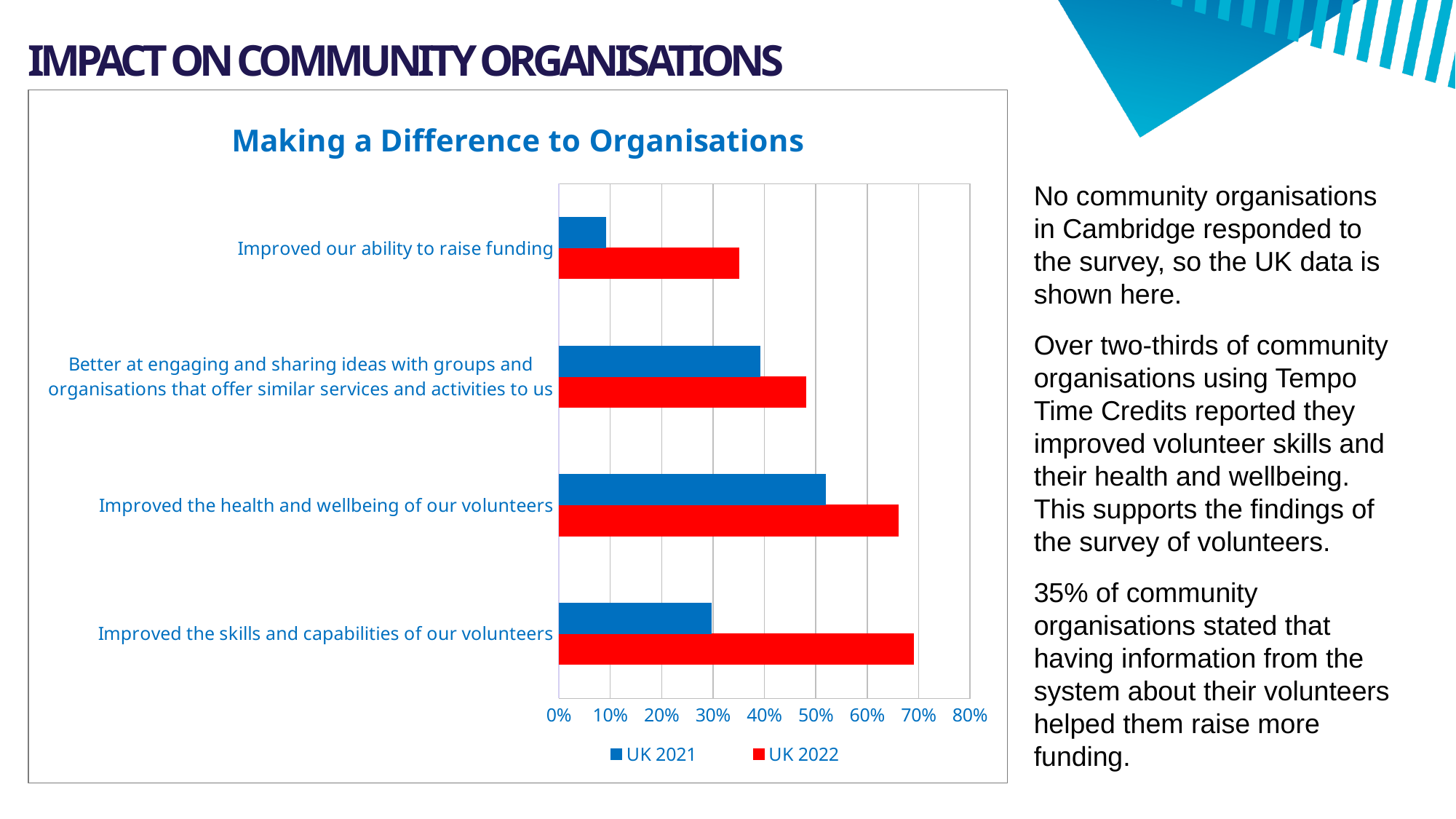
Is the UK 2022 value for 'Improved the health and wellbeing of our volunteers' greater or less than 60%? greater Which category has the highest value for UK 2021? Improved the health and wellbeing of our volunteers Which category has the lowest value for UK 2022? Improved our ability to raise funding Which category has the lowest value for UK 2021? Improved our ability to raise funding For 'Improved the skills and capabilities of our volunteers', which series has the larger value, UK 2021 or UK 2022? UK 2022 How many series does the chart legend list? 2 Is the UK 2022 value for 'Improved our ability to raise funding' greater or less than 30%? greater Is the UK 2021 value for 'Improved the skills and capabilities of our volunteers' greater or less than 40%? less How many categories are shown on the chart? 4 What kind of chart is shown on the slide? bar chart What is the title of the chart? Making a Difference to Organisations